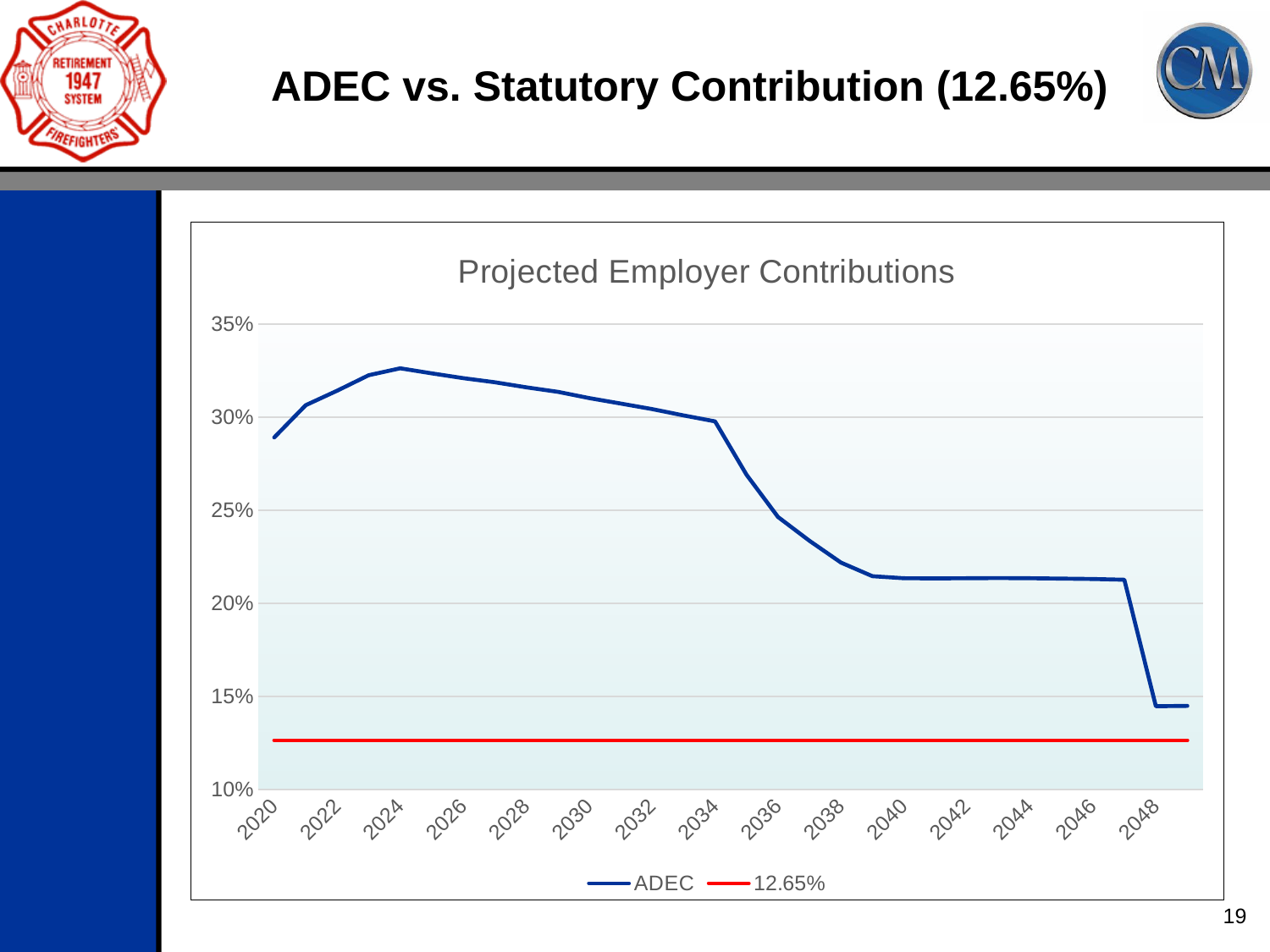
What kind of chart is shown on the slide? line chart What value does the flat red line represent? 12.65% Is the ADEC value for 2024 greater or less than 30%? greater What is the title of the chart? Projected Employer Contributions Is the ADEC value for 2048 greater or less than 20%? less Which is larger, the ADEC value for 2024 or the ADEC value for 2044? 2024 Is the ADEC value for 2020 greater or less than 25%? greater How many series does the chart legend list? 2 Does the ADEC line rise or fall between 2034 and 2040? fall In 2030, which line is higher, ADEC or the 12.65% line? ADEC What are the two entries in the chart legend? ADEC and 12.65%